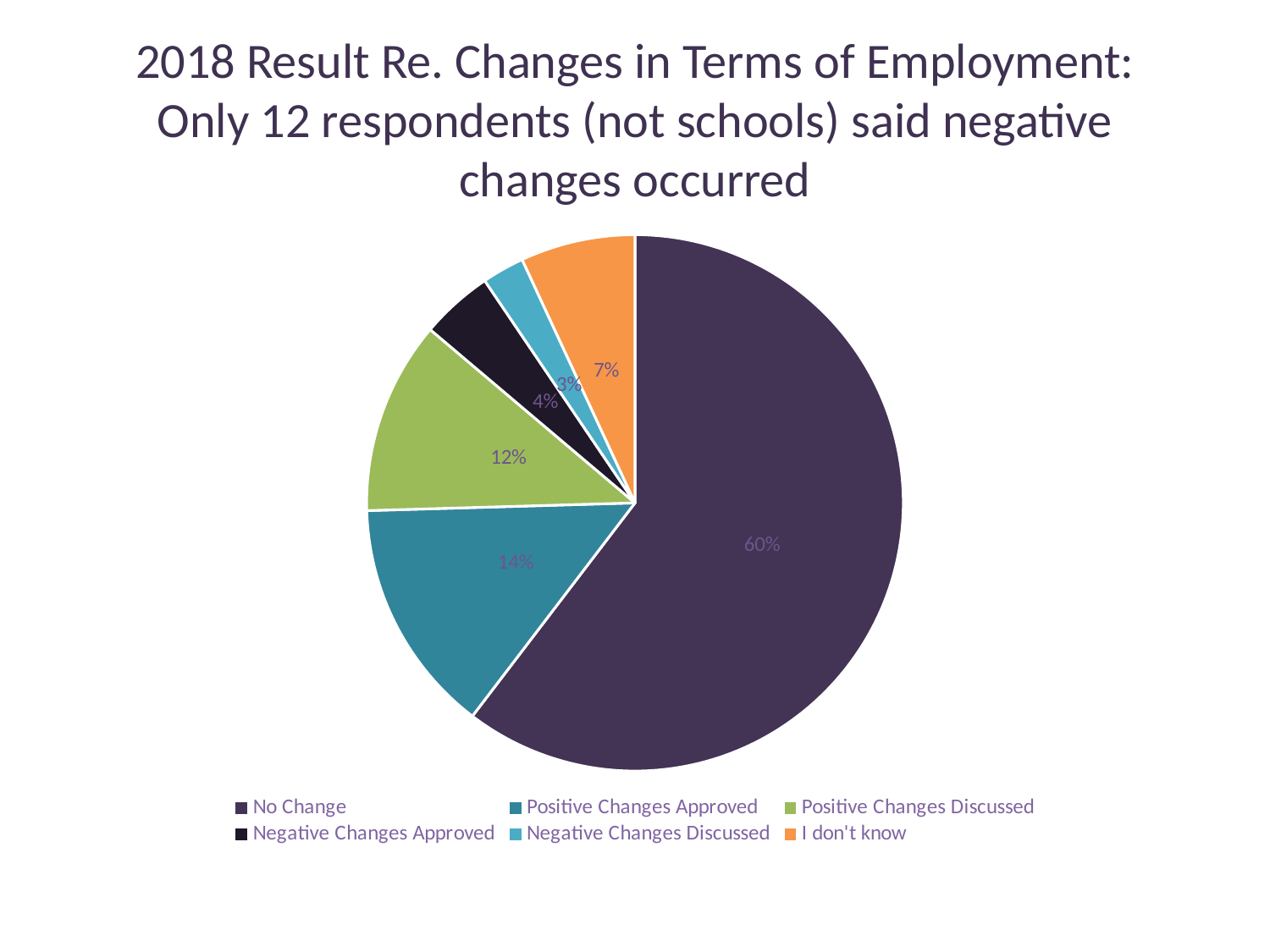
Which is larger, the slice for "Positive Changes Discussed" or the slice for "I don't know"? Positive Changes Discussed Which category has the largest slice of the pie? No Change What percentage is shown for "Positive Changes Approved"? 14% What is the difference in percentage points between "No Change" and "Positive Changes Approved"? 46% What type of chart is shown on the slide? Pie chart What percentage is shown for "I don't know"? 7% Which category has the smallest slice of the pie? Negative Changes Discussed How many categories does the legend list? 6 What percentage is shown for "Negative Changes Approved"? 4% What percentage is shown for "Positive Changes Discussed"? 12% What colour is the slice for "I don't know"? Orange What share of the pie does "No Change" represent? 60%